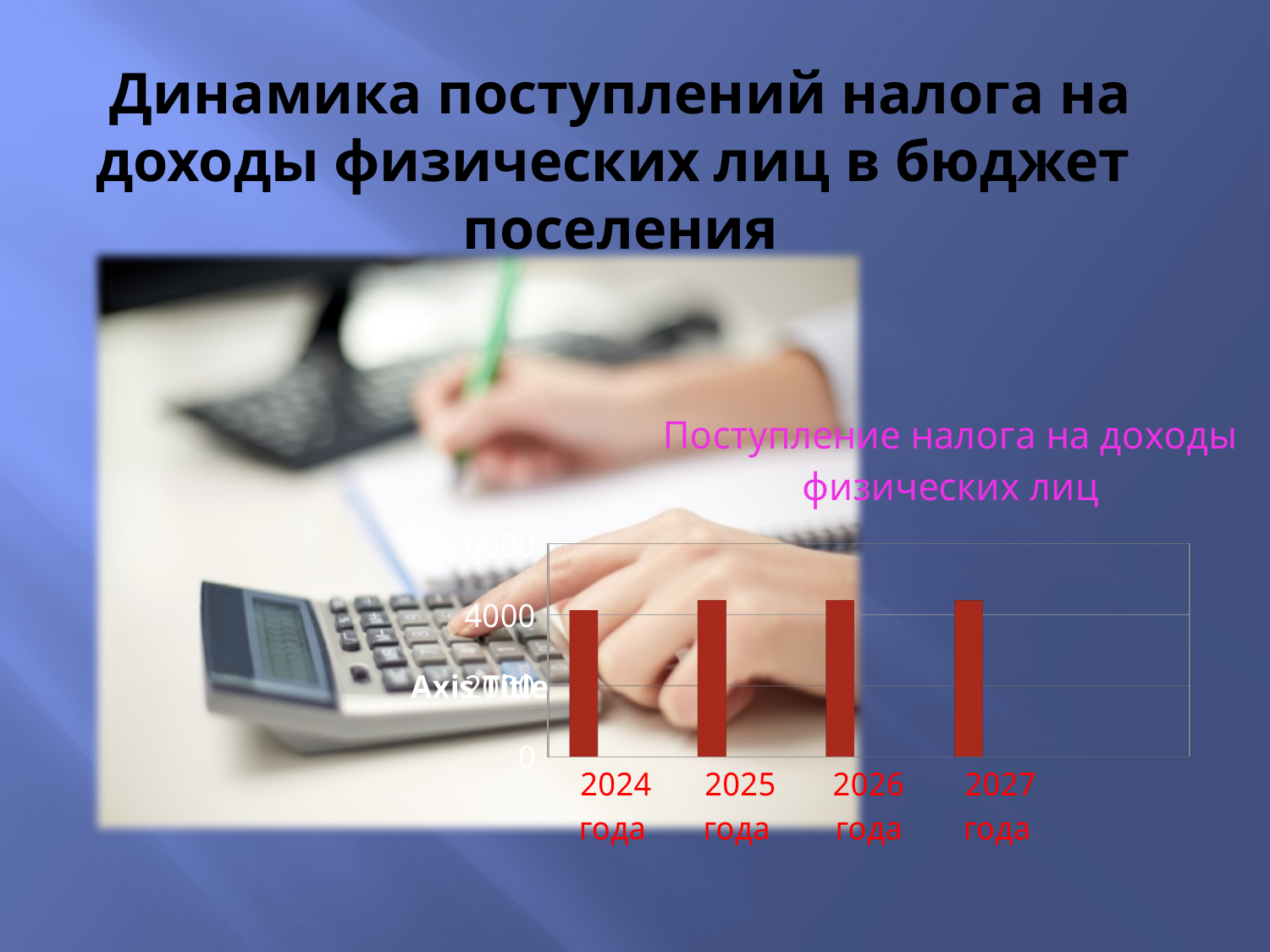
Is the value for 2025 года greater or less than 4000? greater How many categories (years) are shown on the x axis of the chart? 4 What is the title of the chart? Поступление налога на доходы физических лиц What kind of chart is shown on the slide? bar chart Is the value for 2026 года greater or less than 6000? less Which is larger, the value for 2024 года or the value for 2025 года? 2025 года Is the value for 2027 года greater or less than 2000? greater What is the highest tick value shown on the vertical axis of the chart? 6000 Which year has the lowest bar in the chart? 2024 года